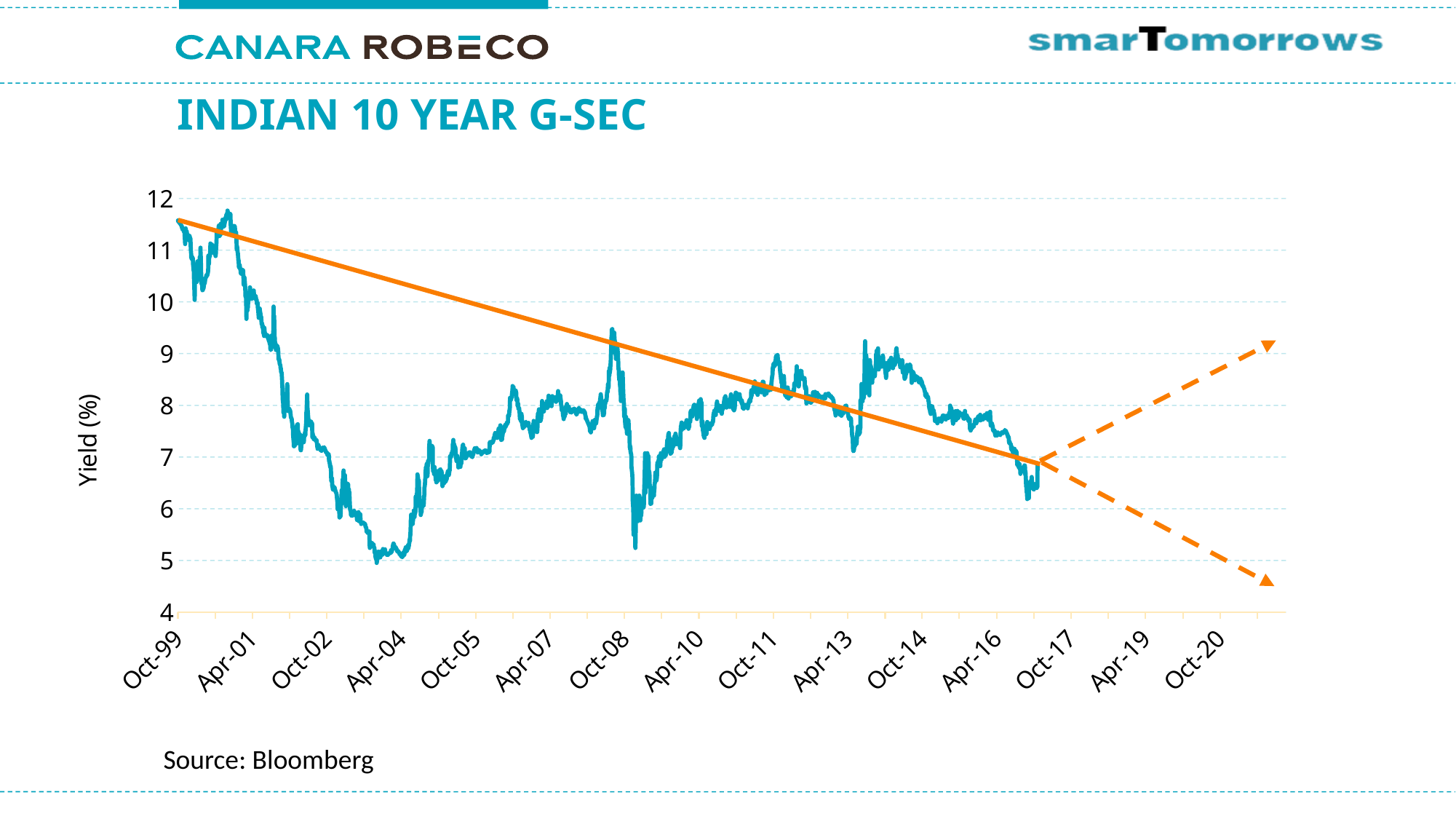
Is the yield at Oct-11 greater or less than 8? greater Does the yield generally rise or fall from Oct-99 to Oct-17? Fall What is the title of the chart? INDIAN 10 YEAR G-SEC Is the yield around Apr-04 greater or less than 6? less Is the yield at Oct-14 greater or less than 8? greater What is the label of the vertical axis? Yield (%) Is the yield higher at Oct-99 or at Apr-04? Oct-99 Around which x-axis label does the yield reach its lowest point? Apr-04 How many date labels are shown on the x axis? 15 What kind of chart is shown on the slide? Line chart